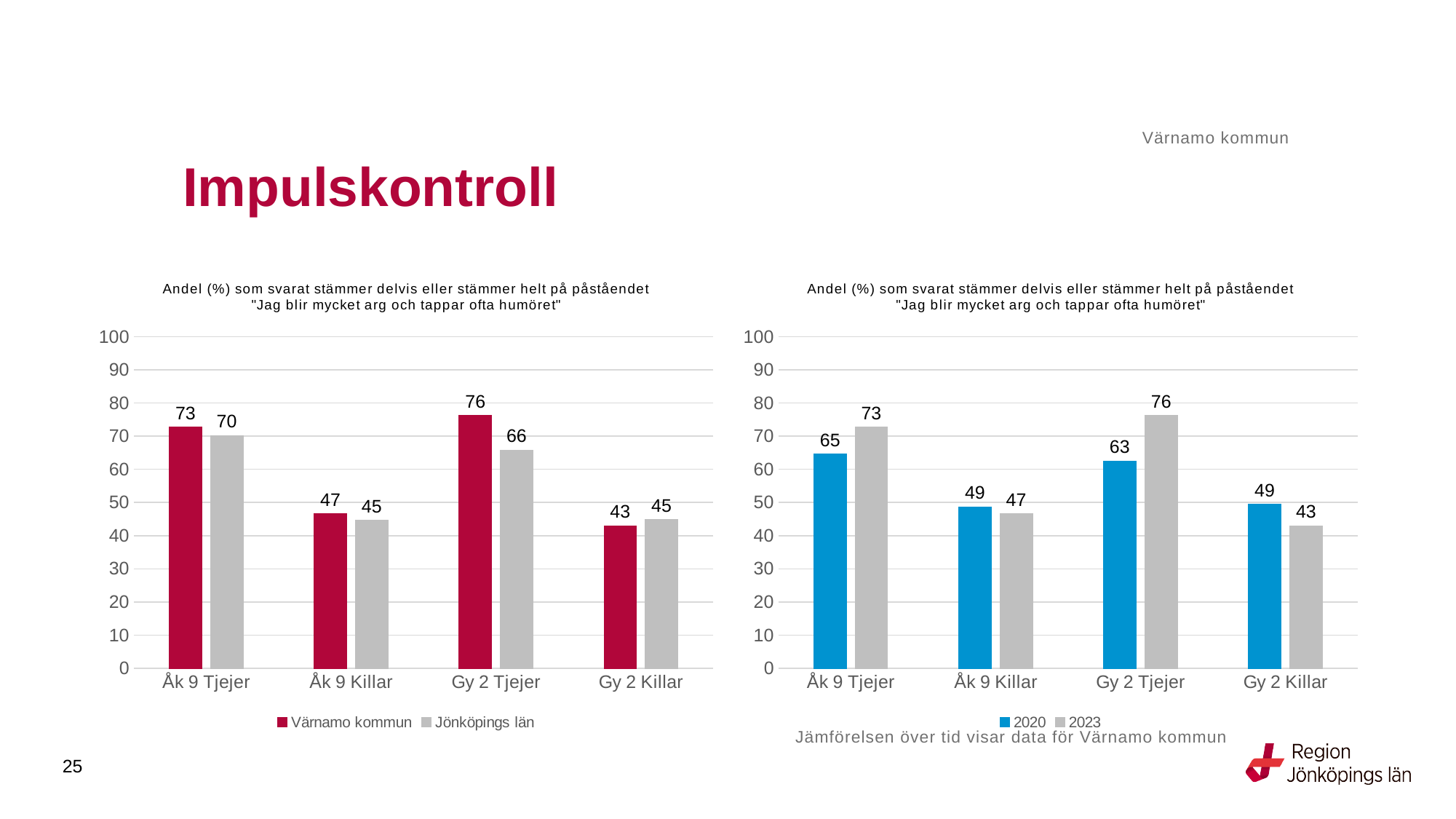
How many series does the legend of the left chart list? 2 In the right chart, what is the 2023 value for Gy 2 Killar? 43 In the left chart, what is the value for Värnamo kommun for Gy 2 Tjejer? 76 In the right chart, is the 2023 value for Åk 9 Tjejer greater or less than 70? greater In the right chart, what is the difference between the 2023 and 2020 values for Gy 2 Tjejer? 13 In the right chart, which category has the lowest 2020 value? Åk 9 Killar and Gy 2 Killar (both 49) In the right chart, what is the 2020 value for Åk 9 Tjejer? 65 In the left chart, what is the value for Jönköpings län for Åk 9 Killar? 45 In the left chart, which is larger for Gy 2 Killar: Värnamo kommun or Jönköpings län? Jönköpings län In the left chart, which category has the highest value for Värnamo kommun? Gy 2 Tjejer How many categories are shown on the x axis of the right chart? 4 In the left chart, what is the difference between Värnamo kommun and Jönköpings län for Gy 2 Tjejer? 10